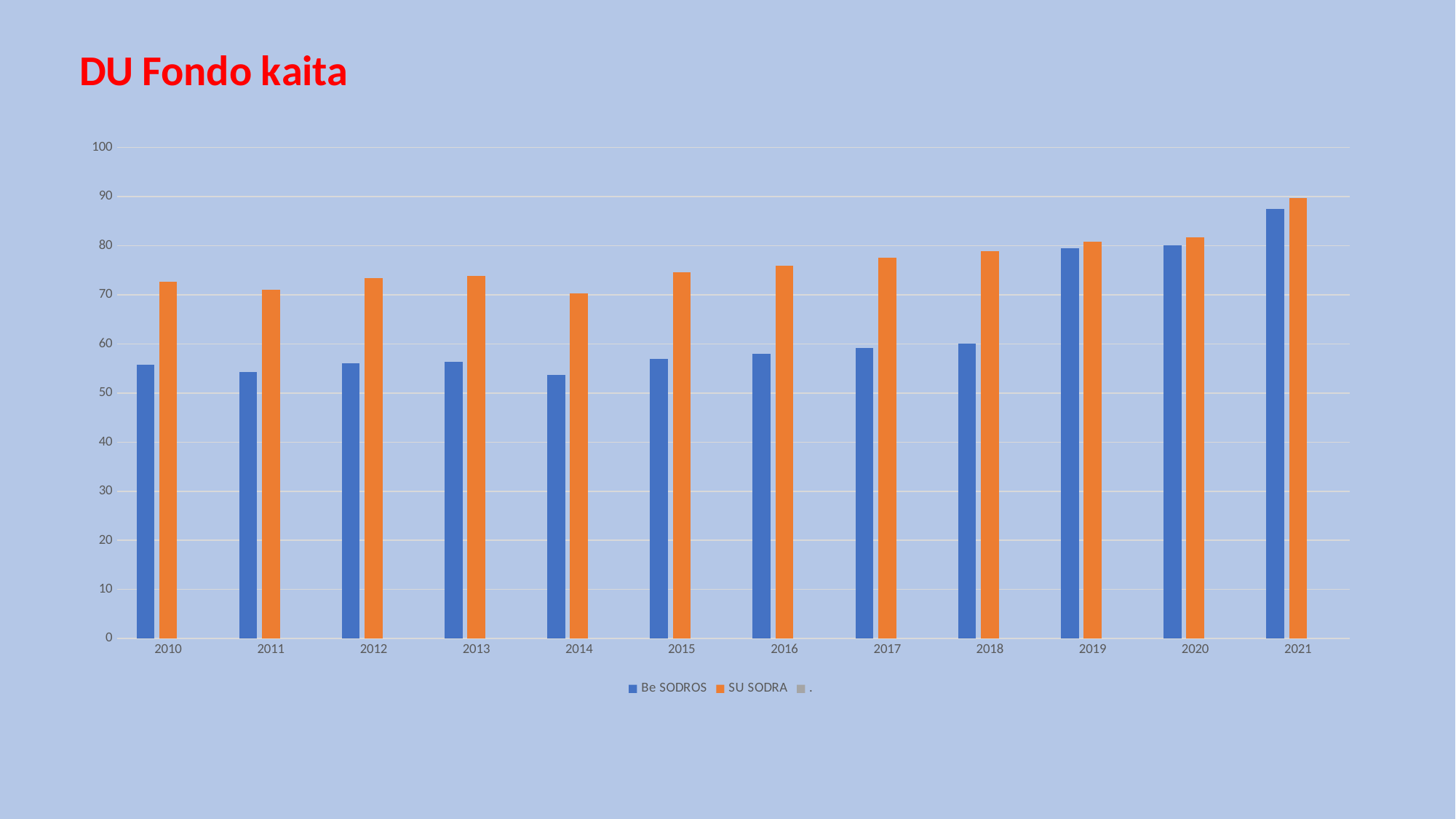
Do the SU SODRA values rise or fall from 2014 to 2021? rise How many entries does the chart's legend list? 3 In which year is the Be SODROS value highest? 2021 Which colour represents the Be SODROS series? blue What kind of chart is shown on the slide? bar chart Is the Be SODROS value for 2010 greater or less than 60? less In 2015, which series has the larger value, Be SODROS or SU SODRA? SU SODRA What is the title of the chart? DU Fondo kaita In which year is the SU SODRA value highest? 2021 How many years are shown on the x axis of the chart? 12 Is the Be SODROS value for 2021 greater or less than 80? greater Is the SU SODRA value for 2021 greater or less than 80? greater